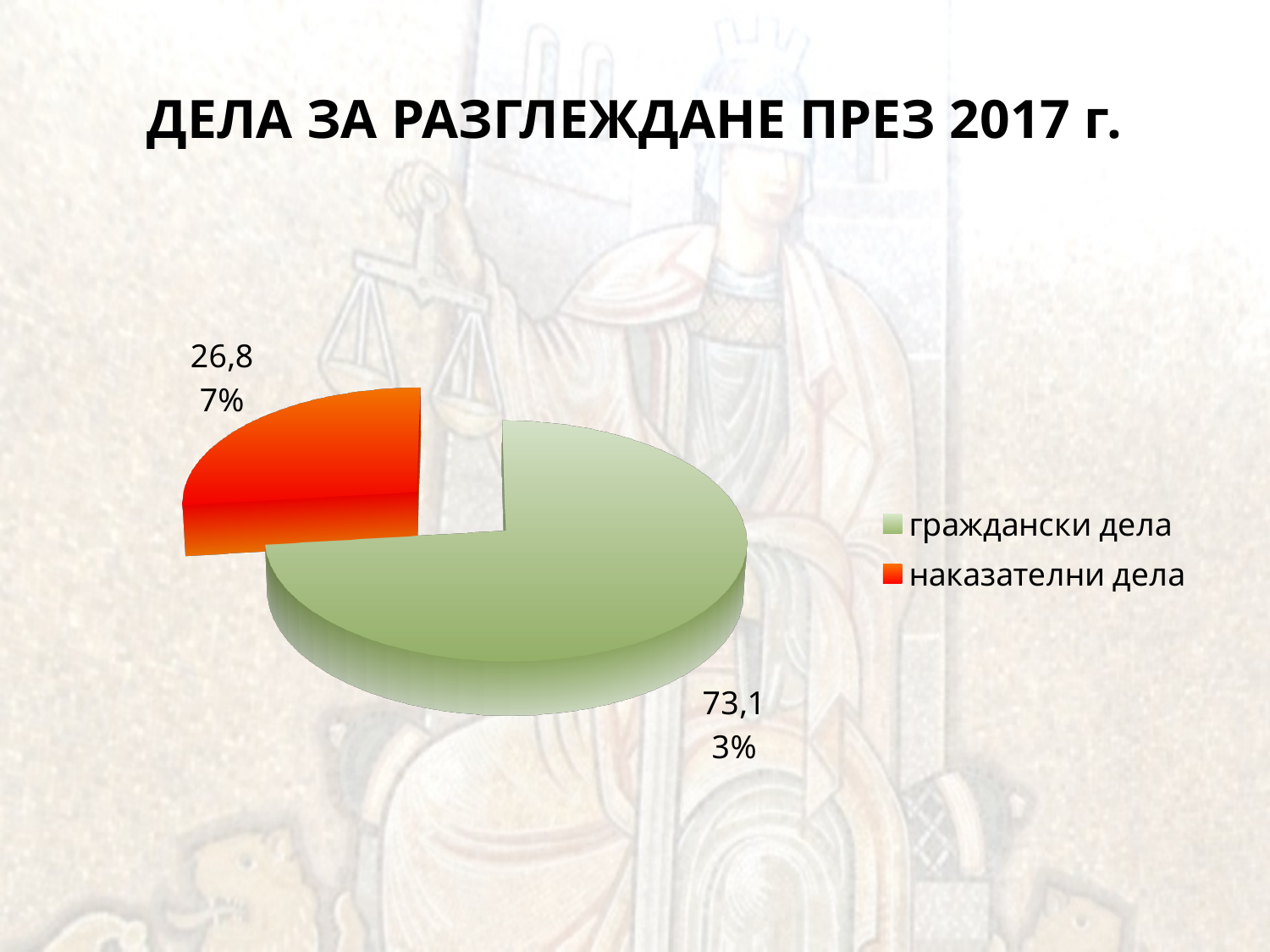
Which category has the smallest share of the pie? наказателни дела What colour is the slice for наказателни дела? red How many slices does the pie chart have? 2 What percentage is shown for граждански дела? 73,13% Is the share for наказателни дела greater or less than 50%? less What is the difference in percentage points between граждански дела and наказателни дела? 46,26 What kind of chart is shown on the slide? pie chart Which is larger, the share for граждански дела or for наказателни дела? граждански дела What percentage is shown for наказателни дела? 26,87% Which category has the largest share of the pie? граждански дела What is the title of the chart on the slide? ДЕЛА ЗА РАЗГЛЕЖДАНЕ ПРЕЗ 2017 г. How many entries does the legend list? 2